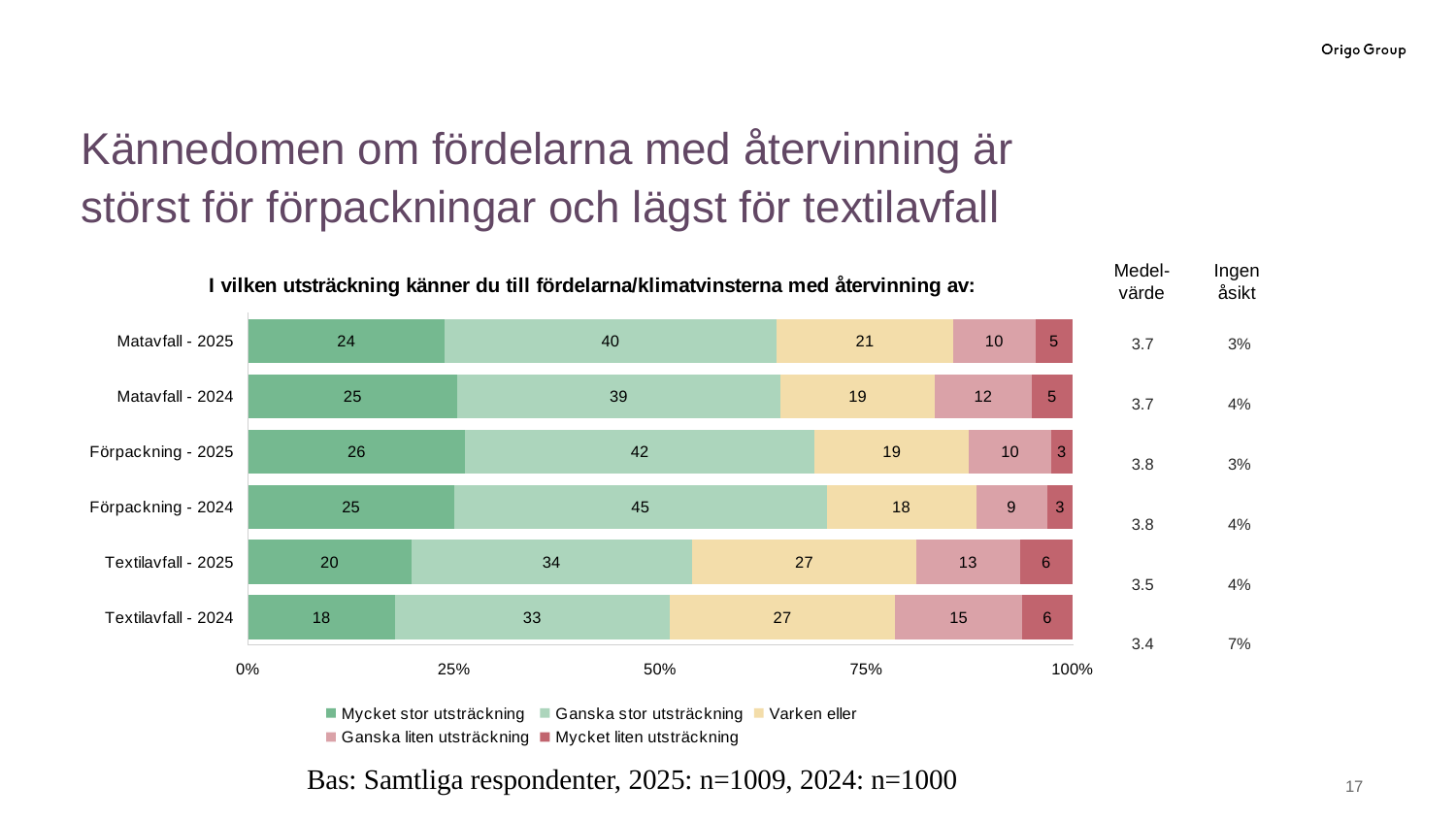
What is the value for "Mycket stor utsträckning" for Förpackning - 2025? 26 What is the first entry in the chart's legend? Mycket stor utsträckning Which has the larger "Mycket stor utsträckning" value, Matavfall - 2025 or Matavfall - 2024? Matavfall - 2024 Which category has the lowest value for "Mycket stor utsträckning"? Textilavfall - 2024 What is the difference between the "Ganska liten utsträckning" values for Textilavfall - 2024 and Förpackning - 2024? 6 What is the total of the stacked bar for Matavfall - 2025? 100 How many categories are shown on the chart? 6 What is the value for "Mycket liten utsträckning" for Textilavfall - 2025? 6 How many series does the legend list? 5 Which category has the highest value for "Ganska stor utsträckning"? Förpackning - 2024 What is the value for "Varken eller" for Textilavfall - 2024? 27 What kind of chart is shown on the slide? Stacked bar chart